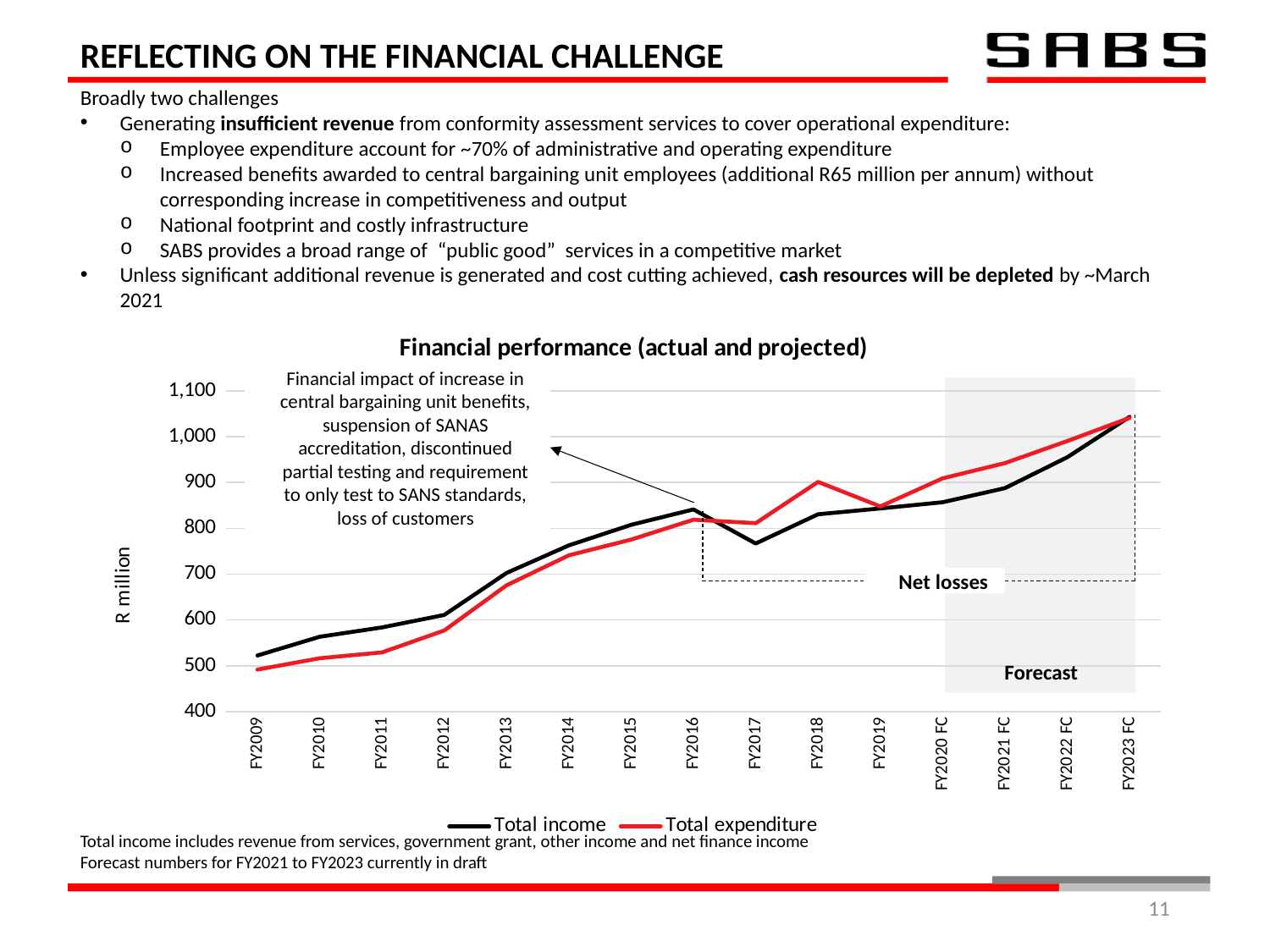
How many fiscal years are plotted along the x axis of the chart? 15 In FY2018, which is larger: Total income or Total expenditure? Total expenditure In FY2009, which is larger: Total income or Total expenditure? Total income What kind of chart is shown on the slide? Line chart How many series does the legend of the chart list? 2 Is the value for Total income in FY2009 greater or less than 500? greater What is the title of the chart? Financial performance (actual and projected) Is the value for Total income in FY2023 FC greater or less than 1,000? greater Is the value for Total income in FY2017 greater or less than 800? less In which fiscal year is Total income at its highest? FY2023 FC What is the label on the vertical axis of the chart? R million